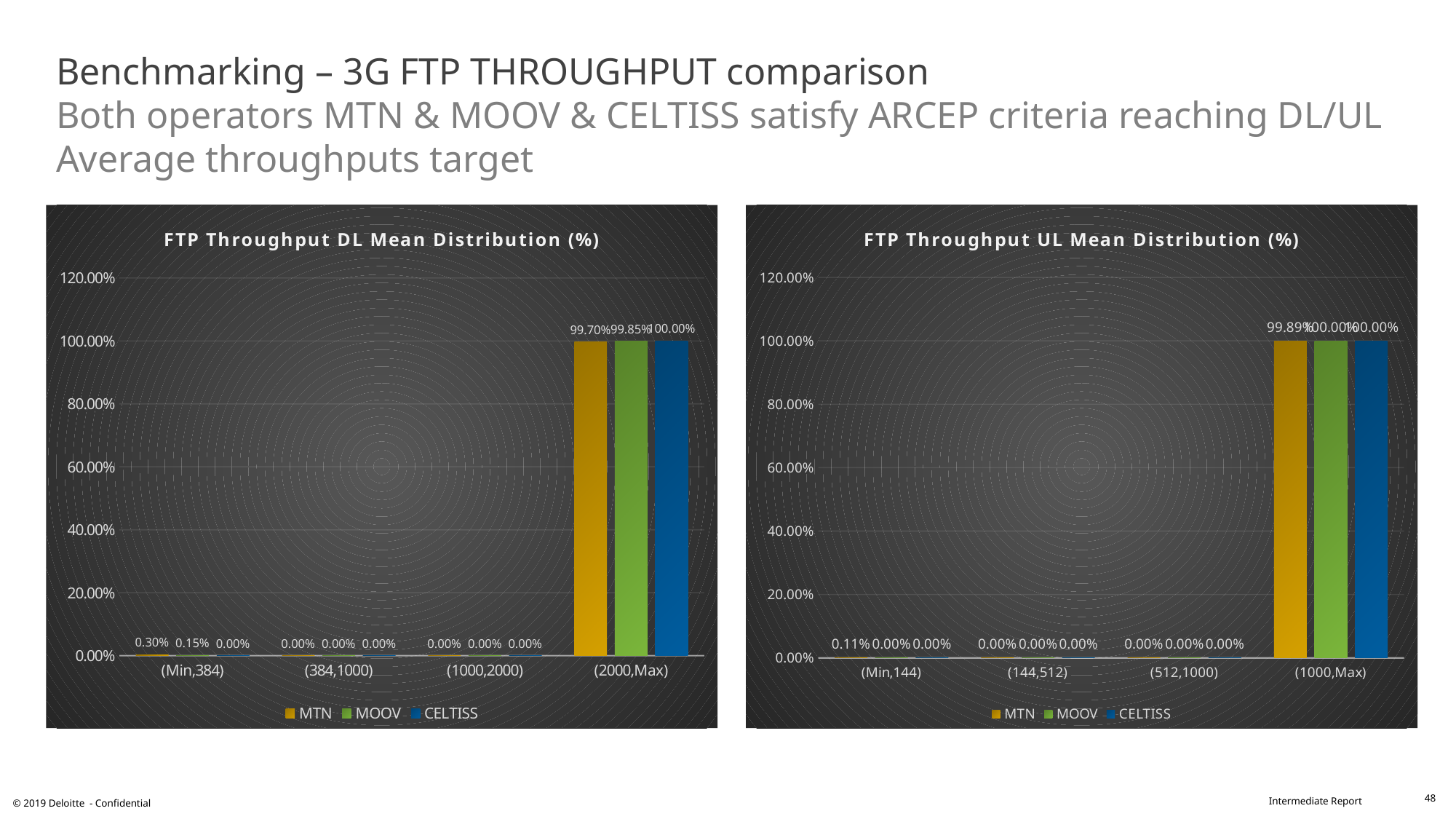
In the FTP Throughput UL Mean Distribution (%) chart, is the value for MOOV in the (1000,Max) category greater or less than 80.00%? greater In the FTP Throughput DL Mean Distribution (%) chart, what is the value for MOOV in the (Min,384) category? 0.15% What is the title of the chart on the right side of the slide? FTP Throughput UL Mean Distribution (%) In the FTP Throughput UL Mean Distribution (%) chart, what is the value for MTN in the (Min,144) category? 0.11% In the FTP Throughput UL Mean Distribution (%) chart, what is the value for MTN in the (1000,Max) category? 99.89% In the FTP Throughput DL Mean Distribution (%) chart, which series is shown in blue? CELTISS In the FTP Throughput DL Mean Distribution (%) chart, what is the value for MTN in the (2000,Max) category? 99.70% How many series does the legend of the FTP Throughput DL Mean Distribution (%) chart list? 3 In the FTP Throughput DL Mean Distribution (%) chart, what is the difference between the MTN values for (2000,Max) and (Min,384)? 99.40% In the FTP Throughput DL Mean Distribution (%) chart, which category has the highest value for CELTISS? (2000,Max) What kind of chart is the FTP Throughput DL Mean Distribution (%) chart? bar chart How many categories are shown on the x axis of the FTP Throughput UL Mean Distribution (%) chart? 4